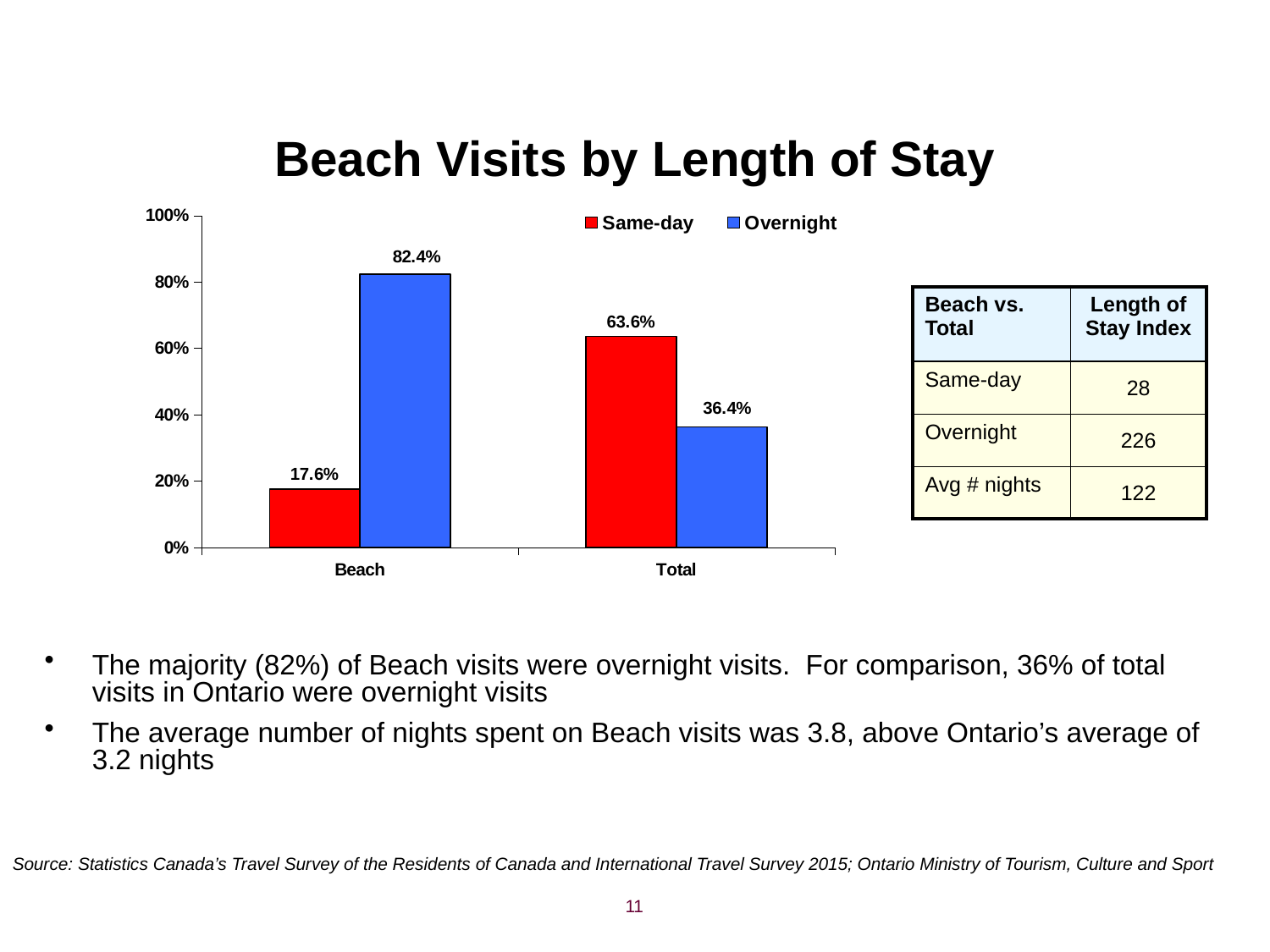
Is the Overnight value for Total greater or less than 40%? less What is the Same-day value for Beach? 17.6% What is the difference between the Overnight and Same-day values for Beach? 64.8% What is the Overnight value for Beach? 82.4% How many categories are shown on the x axis? 2 Which category has the lowest Same-day value? Beach How many series does the legend list? 2 Which is larger for Total: Same-day or Overnight? Same-day Which category has the highest Overnight value? Beach What is the Same-day value for Total? 63.6% What is the Overnight value for Total? 36.4% What kind of chart is shown? bar chart